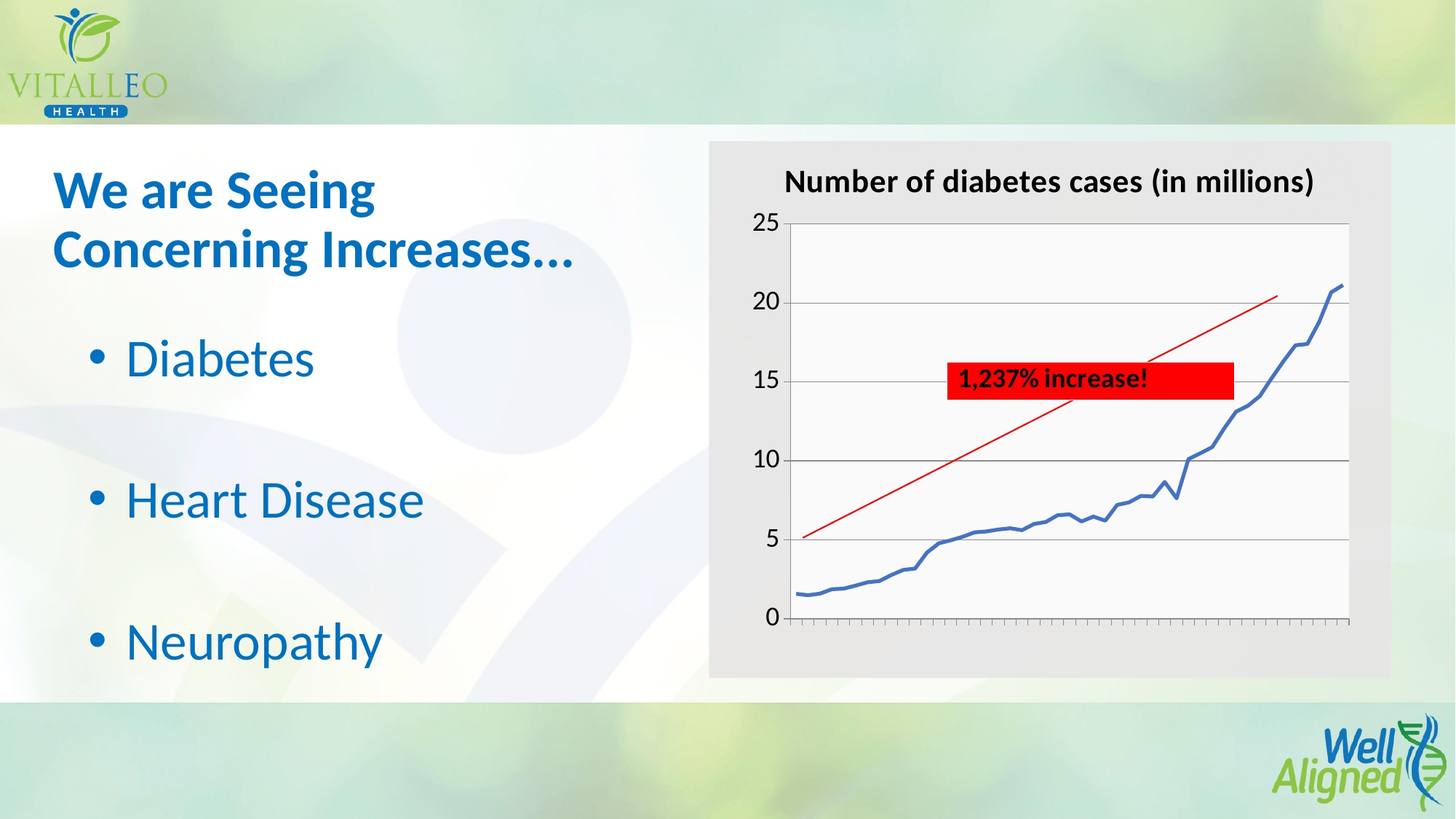
Which end of the line, left or right, has the higher value? right Is the value at the leftmost point of the line greater or less than 5? less Is the lowest value on the line greater or less than 5? less What is the title of the chart? Number of diabetes cases (in millions) Is the value at the rightmost point of the line greater or less than 15? greater Do the values in the chart generally rise or fall from left to right? rise Where along the x axis does the line reach its highest value? at the right end Where along the x axis does the line reach its lowest value? at the left end What kind of chart is shown on the slide? line chart What text is shown in the red box on the chart? 1,237% increase!